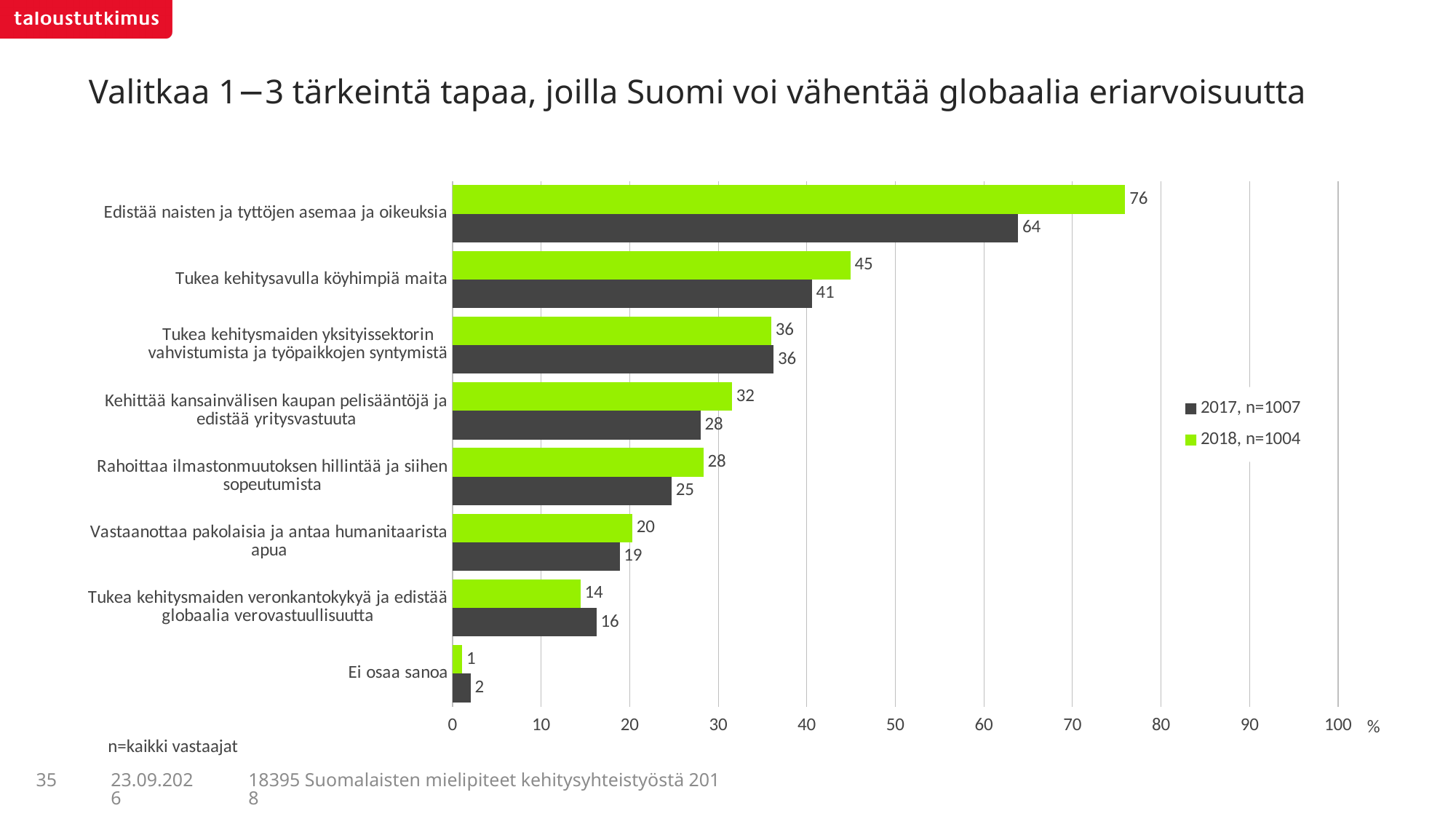
Which category has the highest 2018 value? Edistää naisten ja tyttöjen asemaa ja oikeuksia What kind of chart is shown on the slide? Bar chart What is the difference between the 2018 and 2017 values for "Edistää naisten ja tyttöjen asemaa ja oikeuksia"? 12 Which colour represents the 2018 series in the legend? Green How many categories are shown on the chart? 8 What is the 2018 value for "Edistää naisten ja tyttöjen asemaa ja oikeuksia"? 76 How many series does the legend list? 2 Which category has the lowest 2017 value? Ei osaa sanoa For "Tukea kehitysmaiden veronkantokykyä ja edistää globaalia verovastuullisuutta", which year has the larger value, 2017 or 2018? 2017 What is the 2017 value for "Tukea kehitysavulla köyhimpiä maita"? 41 What is the difference between the 2018 and 2017 values for "Kehittää kansainvälisen kaupan pelisääntöjä ja edistää yritysvastuuta"? 4 What is the 2017 value for "Tukea kehitysmaiden veronkantokykyä ja edistää globaalia verovastuullisuutta"? 16